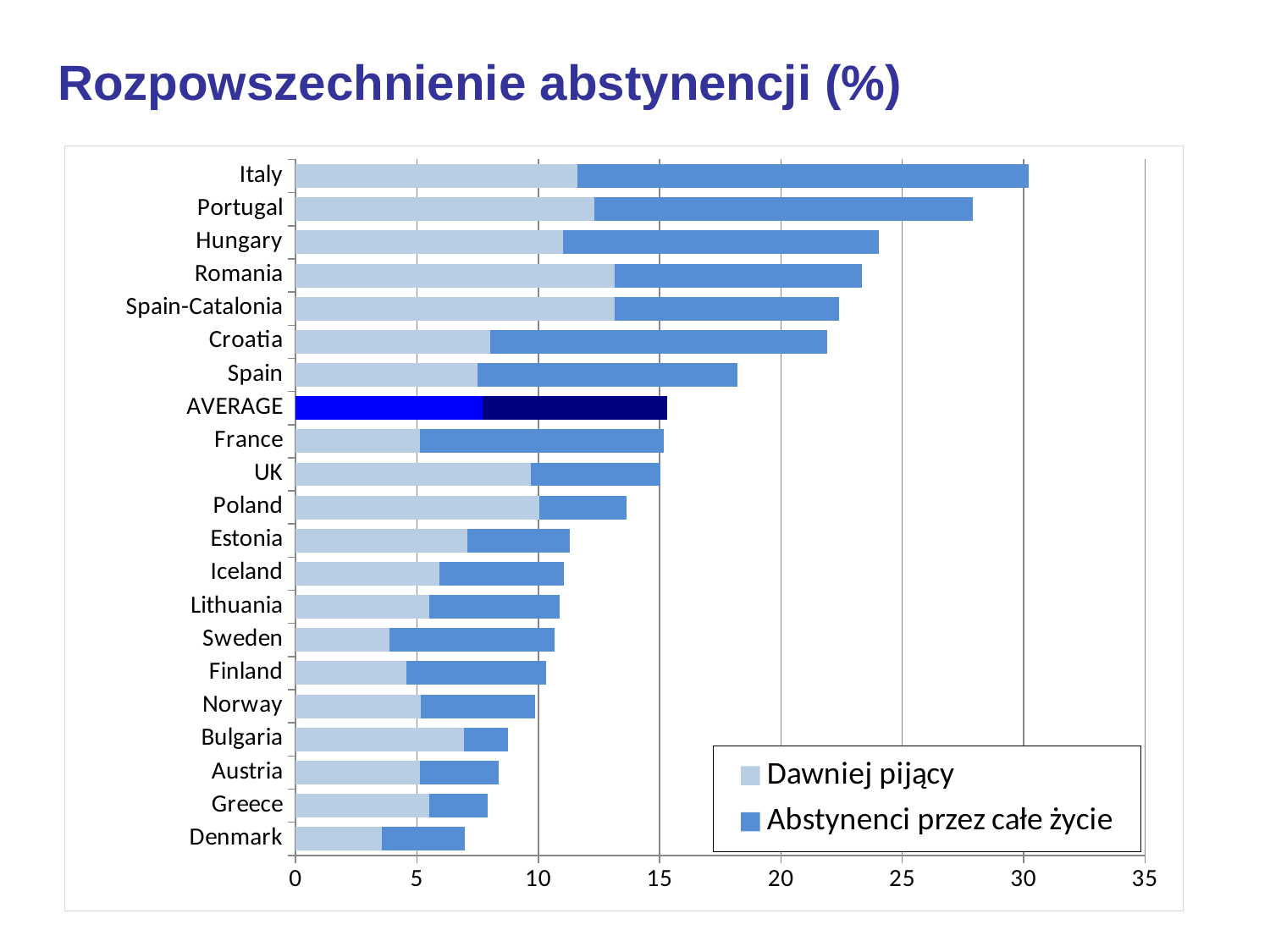
What is the title of the slide? Rozpowszechnienie abstynencji (%) Which has the larger total bar, Poland or Estonia? Poland Is the total value for Denmark greater or less than 10? less Is the total value for Hungary greater or less than 20? greater Which category has the highest total bar? Italy How many series does the legend list? 2 How many categories (countries plus AVERAGE) are plotted on the chart? 21 Which has the larger total bar, Croatia or Spain? Croatia What kind of chart is shown on the slide? Stacked bar chart Which category has the lowest total bar? Denmark Is the total value for Spain greater or less than 20? less